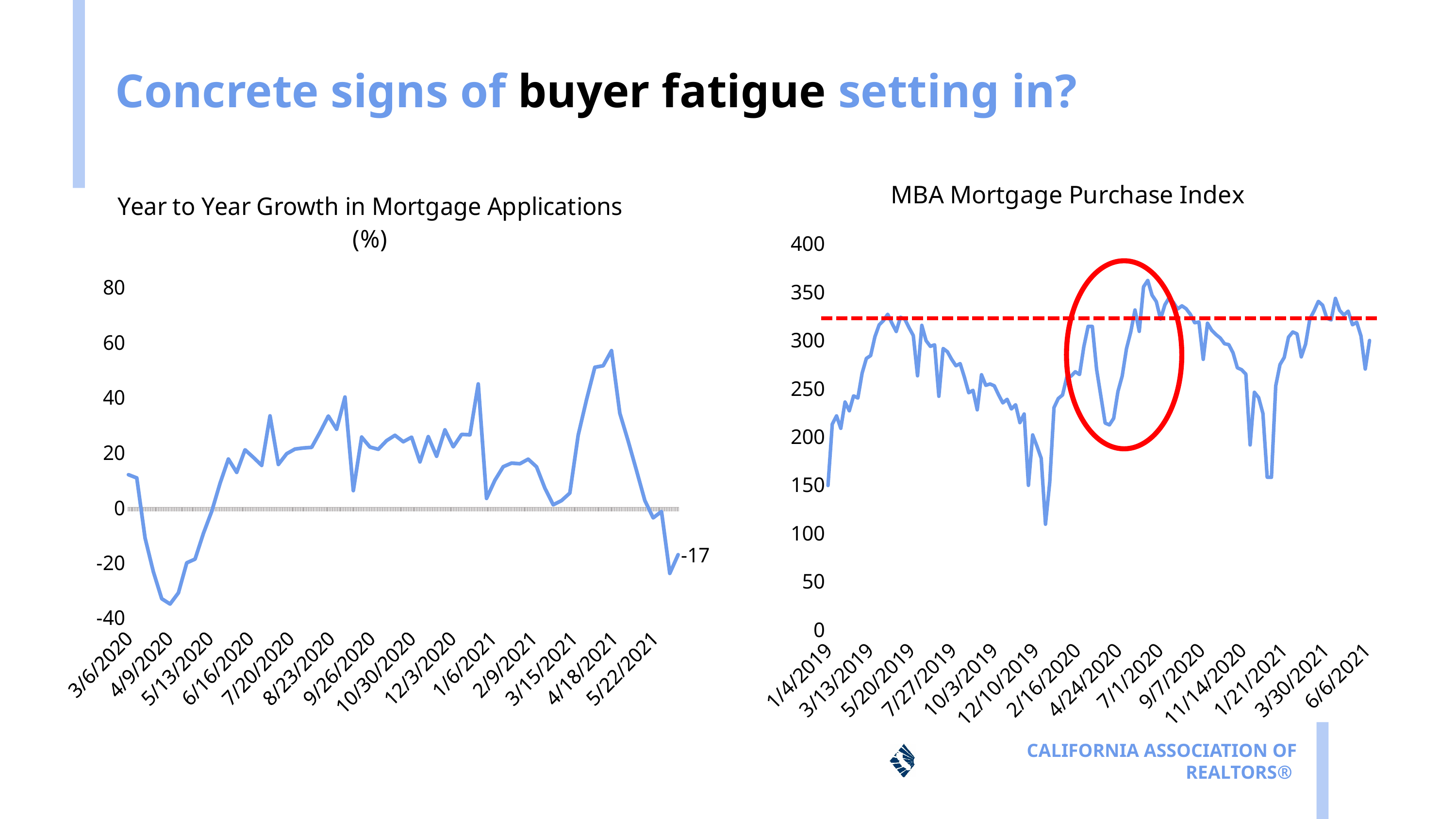
On the right chart, is the value at 1/4/2019 greater or less than 200? less On the left chart, does the line rise or fall between 4/18/2021 and 5/22/2021? fall On the left chart, is the lowest value of the line greater or less than -20? less On the right chart, what is the highest value shown on the y axis? 400 What kind of chart is the left chart, 'Year to Year Growth in Mortgage Applications (%)'? line chart On the right chart, what is the last date label on the x axis? 6/6/2021 What kind of chart is the right chart, 'MBA Mortgage Purchase Index'? line chart How many lines are plotted on the left chart? 1 On the left chart, is the peak value near 4/18/2021 greater or less than 40? greater On the left chart, what value is printed as the data label at the end of the line? -17